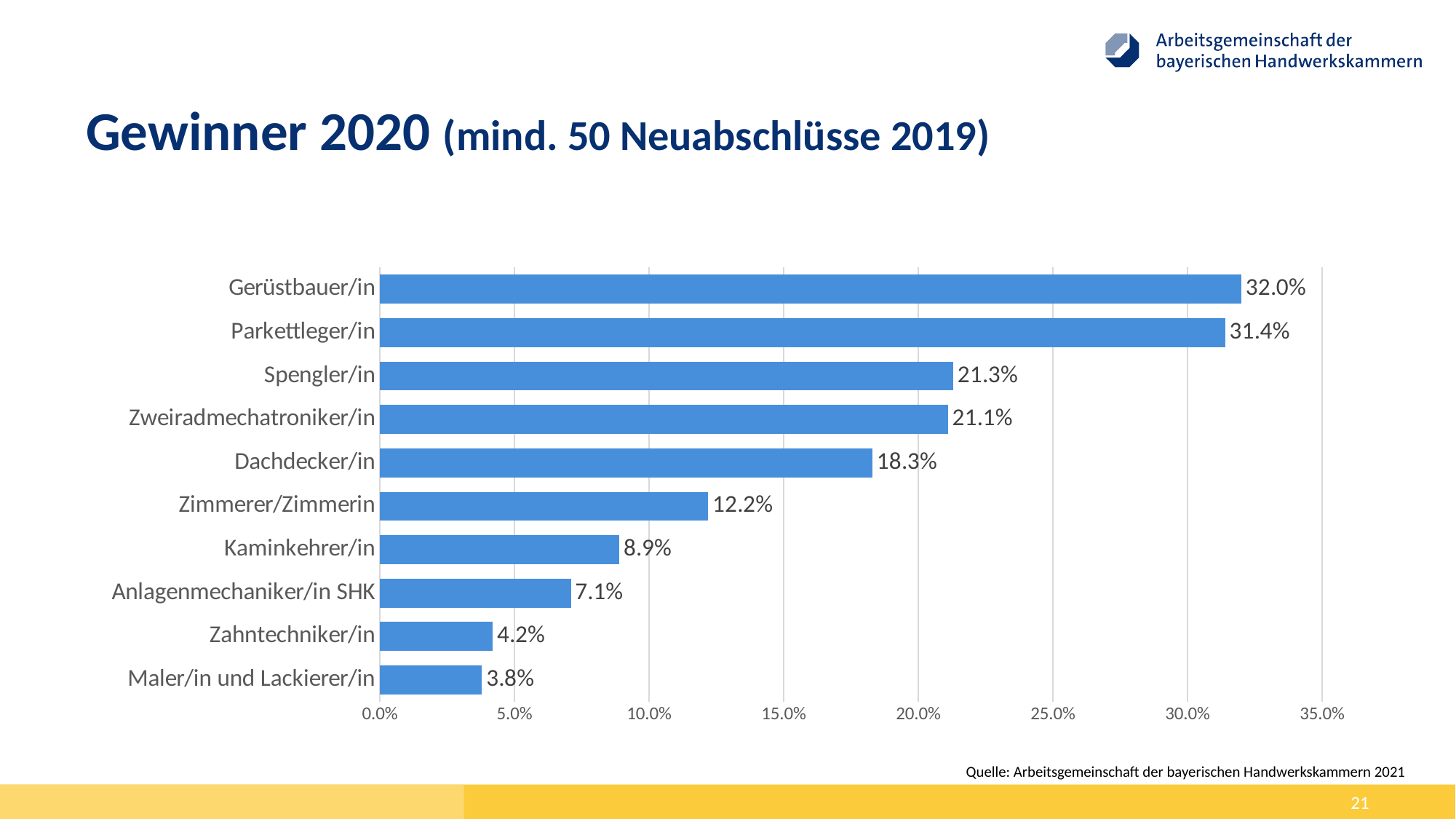
What is the difference between the values for Gerüstbauer/in and Parkettleger/in? 0.6% How many categories are shown in the chart? 10 Is the value for Spengler/in greater or less than 20.0%? greater What is the value for Gerüstbauer/in? 32.0% Which is larger, the value for Kaminkehrer/in or the value for Anlagenmechaniker/in SHK? Kaminkehrer/in What is the difference between the values for Dachdecker/in and Zimmerer/Zimmerin? 6.1% What is the title of the slide? Gewinner 2020 (mind. 50 Neuabschlüsse 2019) Which category has the highest value? Gerüstbauer/in Which category has the lowest value? Maler/in und Lackierer/in What is the value for Zahntechniker/in? 4.2% What kind of chart is shown on the slide? Bar chart What is the value for Dachdecker/in? 18.3%